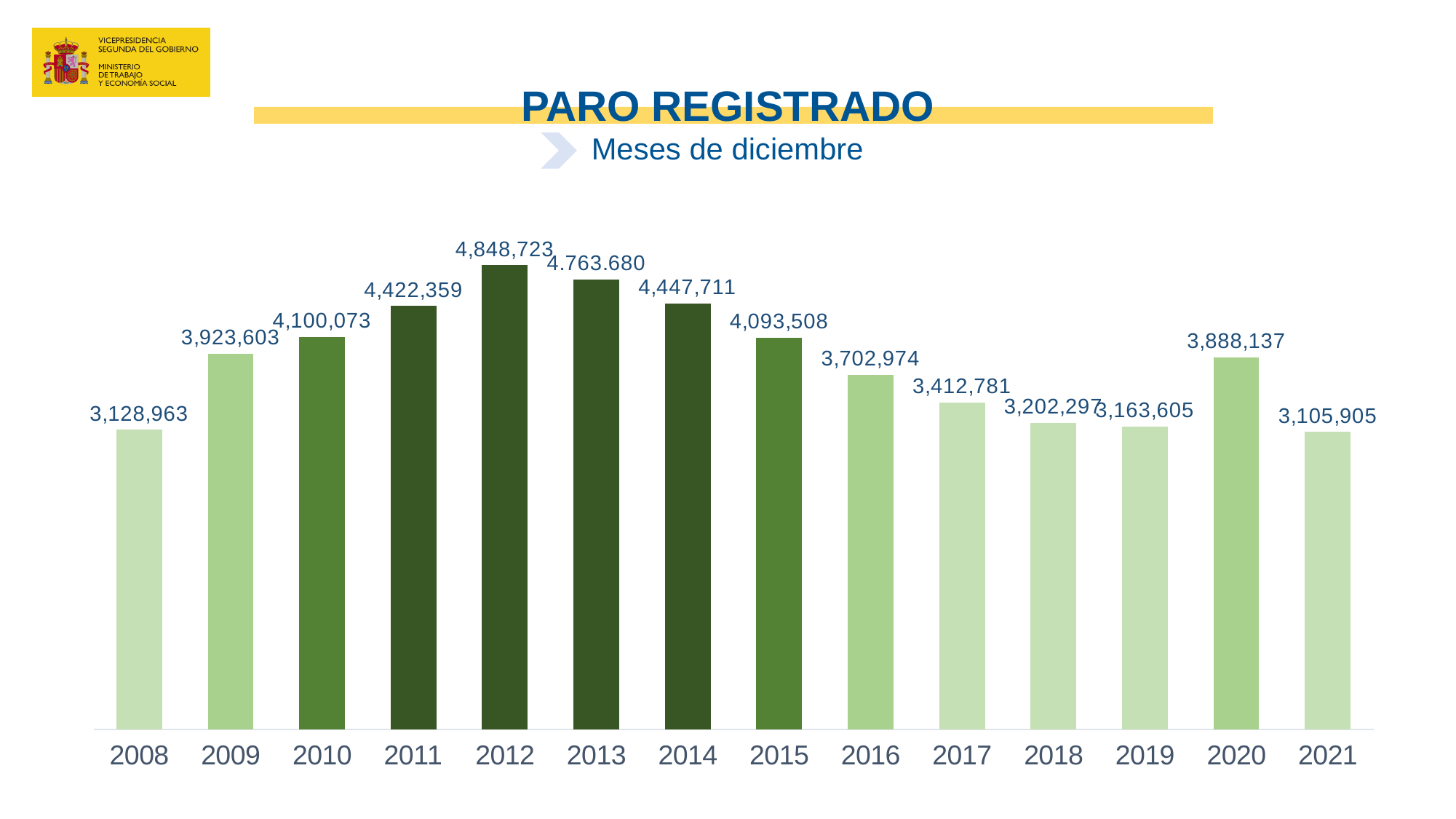
How many years are shown on the x axis? 14 Which year has the highest value? 2012 What kind of chart is shown on the slide? Bar chart What is the title of the chart? PARO REGISTRADO What is the value shown for 2012? 4,848,723 What is the difference between the values for 2012 and 2011? 426,364 What is the value shown for 2016? 3,702,974 What is the difference between the values for 2020 and 2019? 724,532 Which year has the lowest value? 2021 Do the values rise or fall from 2012 to 2019? Fall Which is larger, the value for 2009 or the value for 2020? 2009 What is the value shown for 2021? 3,105,905